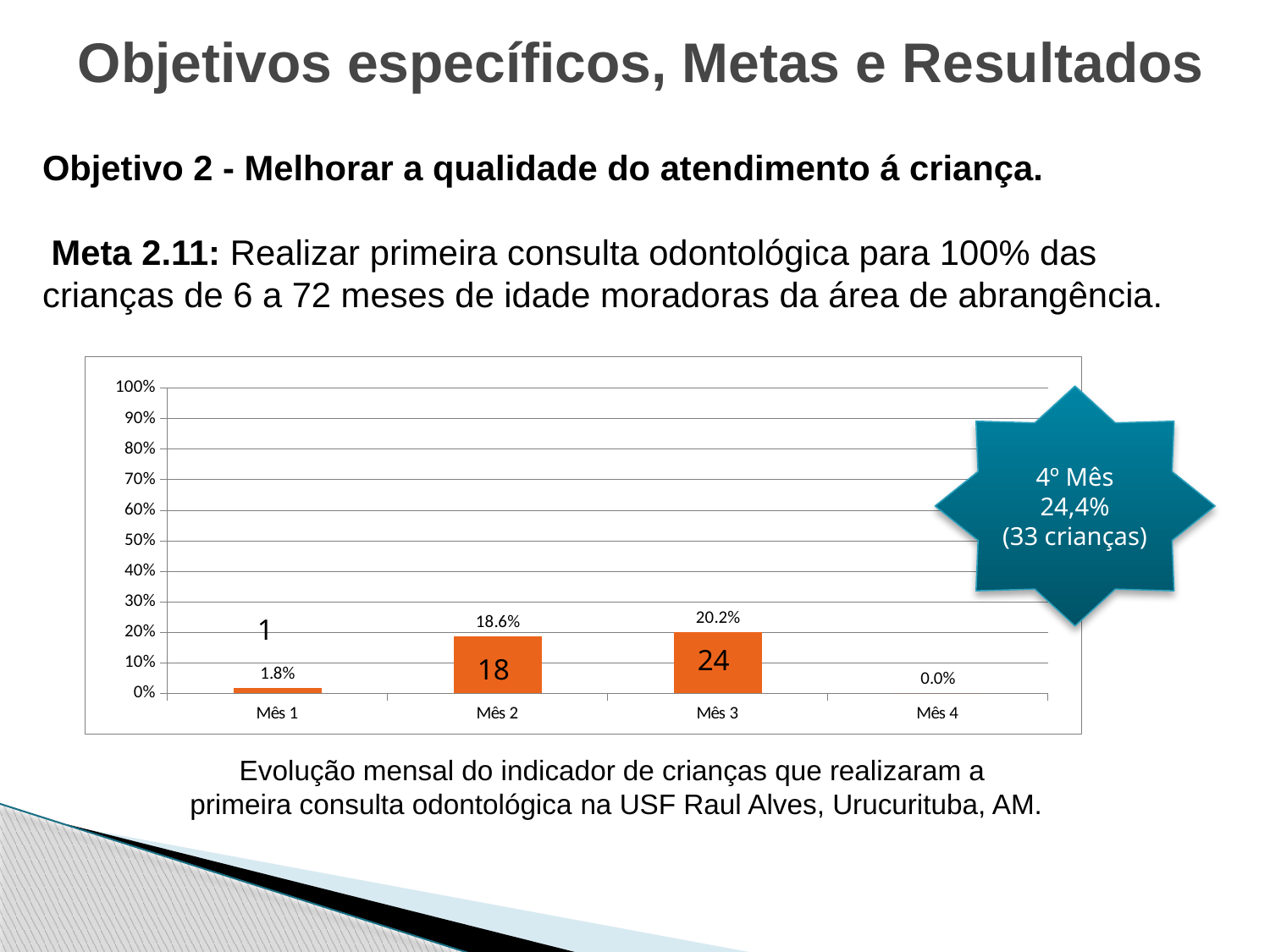
What is the difference in percentage points between Mês 3 and Mês 2? 1.6 percentage points What kind of chart is shown on the slide? Bar chart Which is larger, the percentage for Mês 2 or for Mês 1? Mês 2 What percentage is shown for Mês 1? 1.8% How many months are shown on the x axis of the chart? 4 What percentage is shown for Mês 3? 20.2% Is the value for Mês 2 greater or less than 20%? less Which month has the highest percentage among the bars plotted in the chart? Mês 3 What percentage is shown for Mês 2? 18.6% What number is printed inside the bar for Mês 3? 24 What number is printed inside the bar for Mês 2? 18 Do the percentages rise or fall from Mês 1 to Mês 3? rise